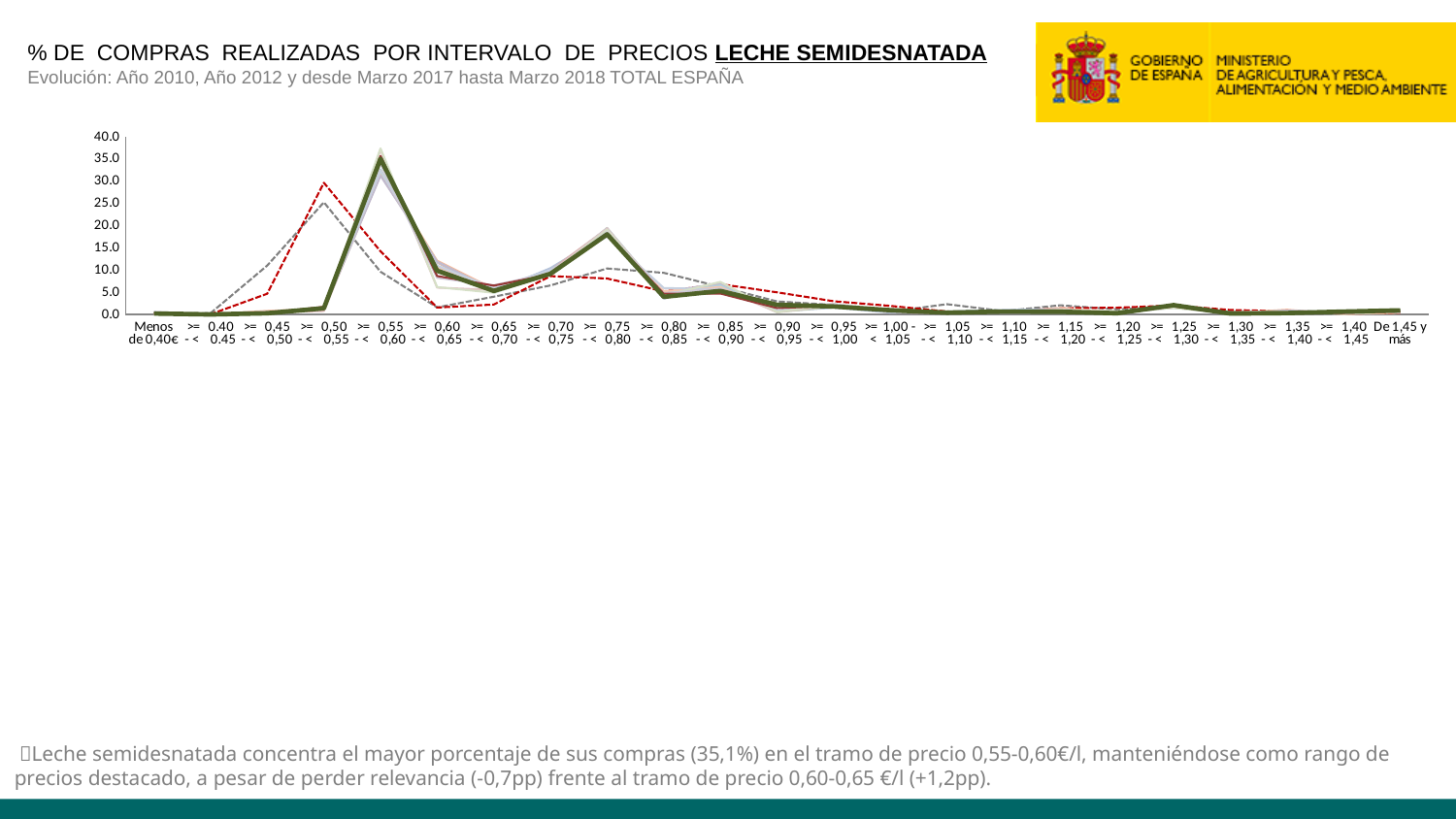
What is the highest value shown on the y axis of the chart? 40.0 Is the value of the solid green line at the >= 0,75 - < 0,80 interval greater or less than 15? greater Is the value of the solid green line at the >= 0,40 - < 0,45 interval greater or less than 5? less Is the peak value of the solid green line at the >= 0,55 - < 0,60 interval greater or less than 30? greater Which is larger at the >= 0,55 - < 0,60 interval: the solid green line or the red dashed line? the solid green line How many price intervals are shown along the x axis of the chart? 23 In which price interval does the red dashed line reach its highest value? >= 0,50 - < 0,55 Which product is named in the chart title on the slide? LECHE SEMIDESNATADA In which price interval does the solid green line reach its highest value? >= 0,55 - < 0,60 Do the values of the solid green line rise or fall from the >= 0,55 - < 0,60 interval to the >= 0,65 - < 0,70 interval? fall What kind of chart is shown on the slide? line chart